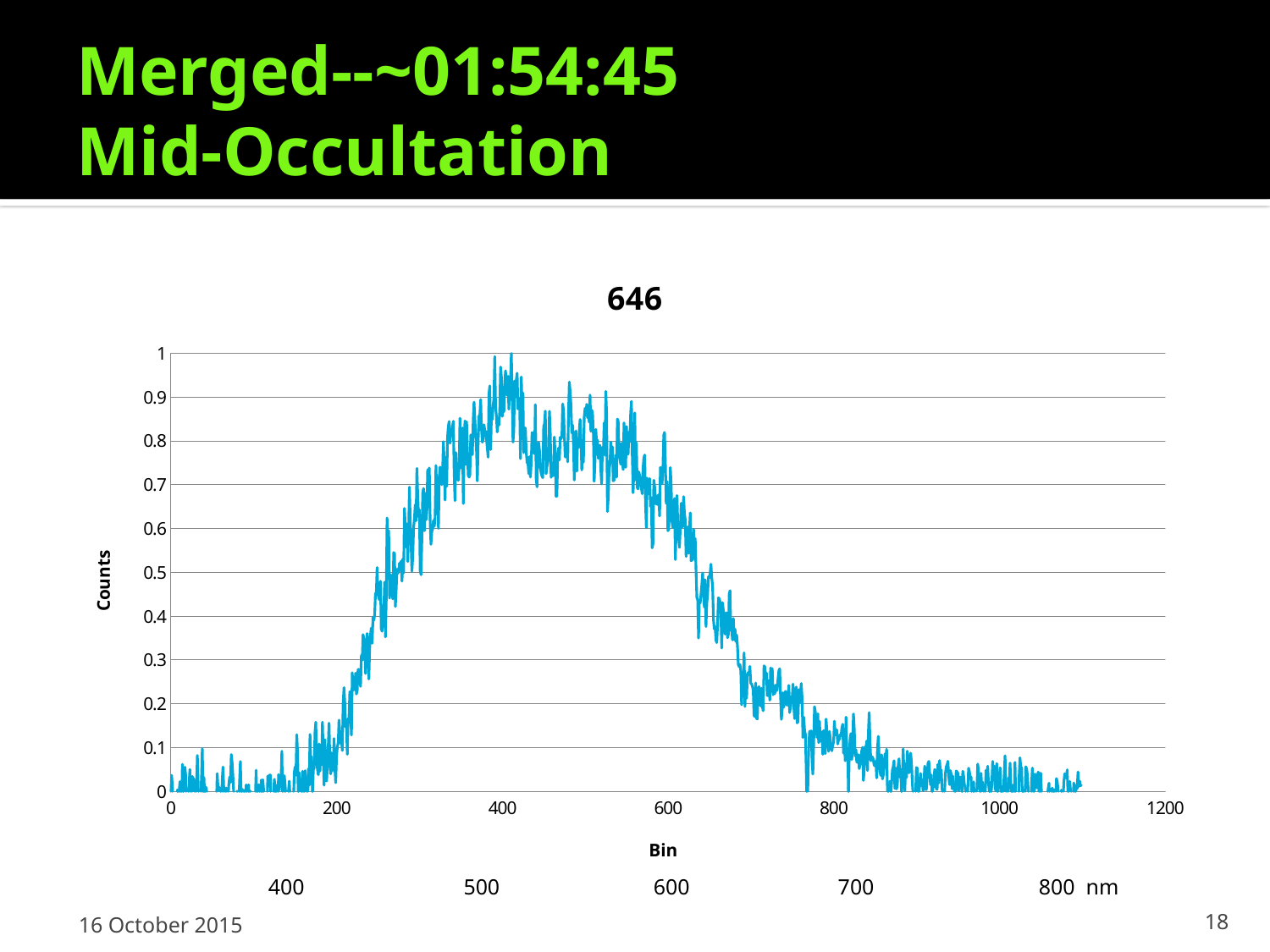
Is the value at bin 1000 greater or less than 0.5? less Is the value at bin 500 greater or less than 0.6? greater Is the value at bin 400 greater or less than 0.5? greater Do the values rise or fall along the x axis between bin 600 and bin 1000? fall What is the label of the y axis? Counts What is the title of the chart? 646 Which is larger, the value at bin 400 or the value at bin 800? bin 400 Which is larger, the value at bin 700 or the value at bin 1000? bin 700 Do the values rise or fall along the x axis between bin 200 and bin 400? rise What kind of chart is shown on the slide? line chart